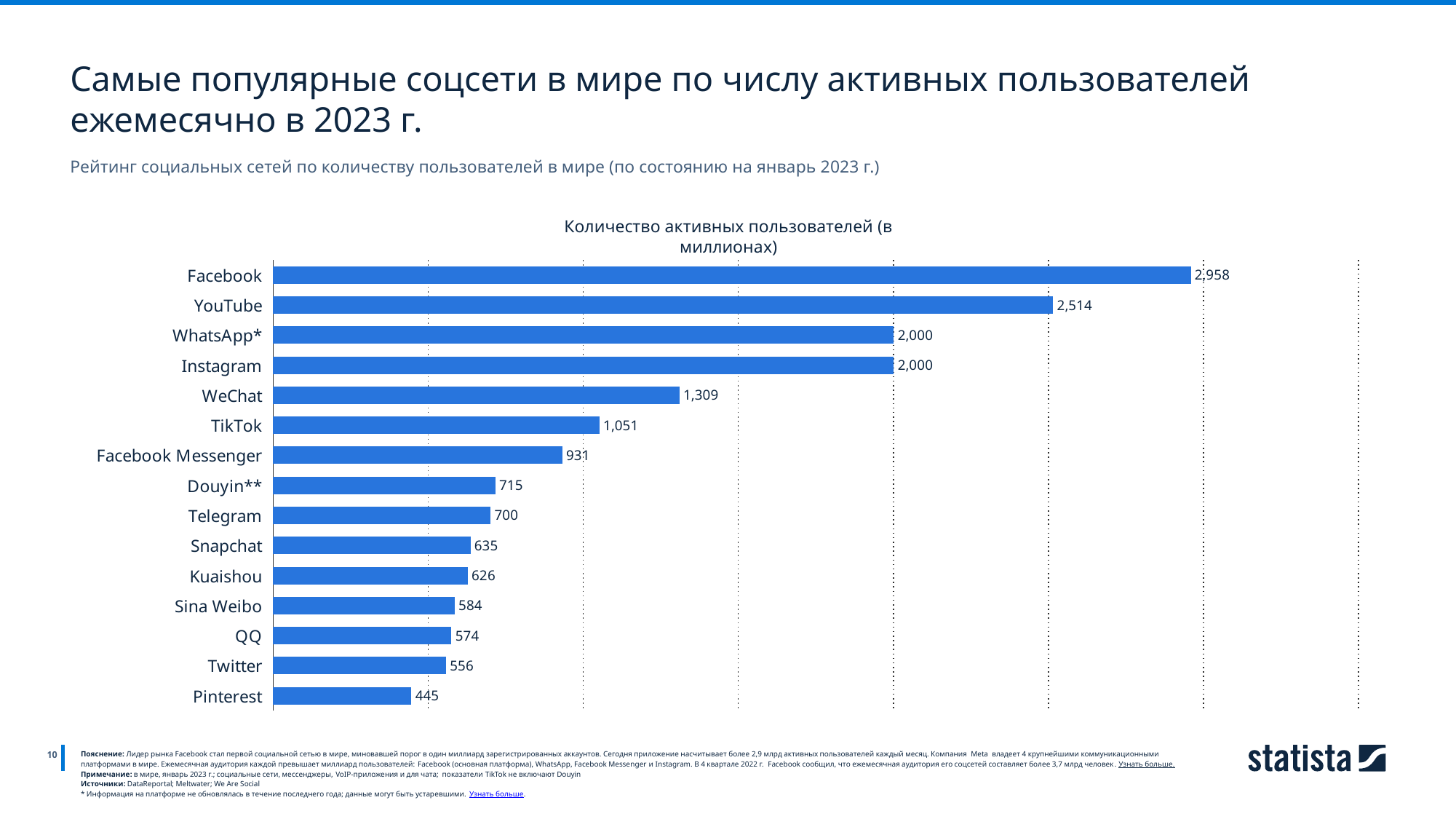
How many social networks are shown on the chart? 15 What is the title of the chart? Количество активных пользователей (в миллионах) What is the difference between the values for WeChat and TikTok? 258 What value is shown for TikTok? 1,051 Which has a larger value, Telegram or Snapchat? Telegram Which social network has the highest number of active users on the chart? Facebook What is the difference between the values for Facebook and YouTube? 444 Which social network has the lowest number of active users on the chart? Pinterest What is the number of active users shown for Facebook? 2,958 Which has a larger value, Facebook Messenger or Douyin**? Facebook Messenger What kind of chart is shown on the slide? Bar chart What value is shown for Pinterest? 445